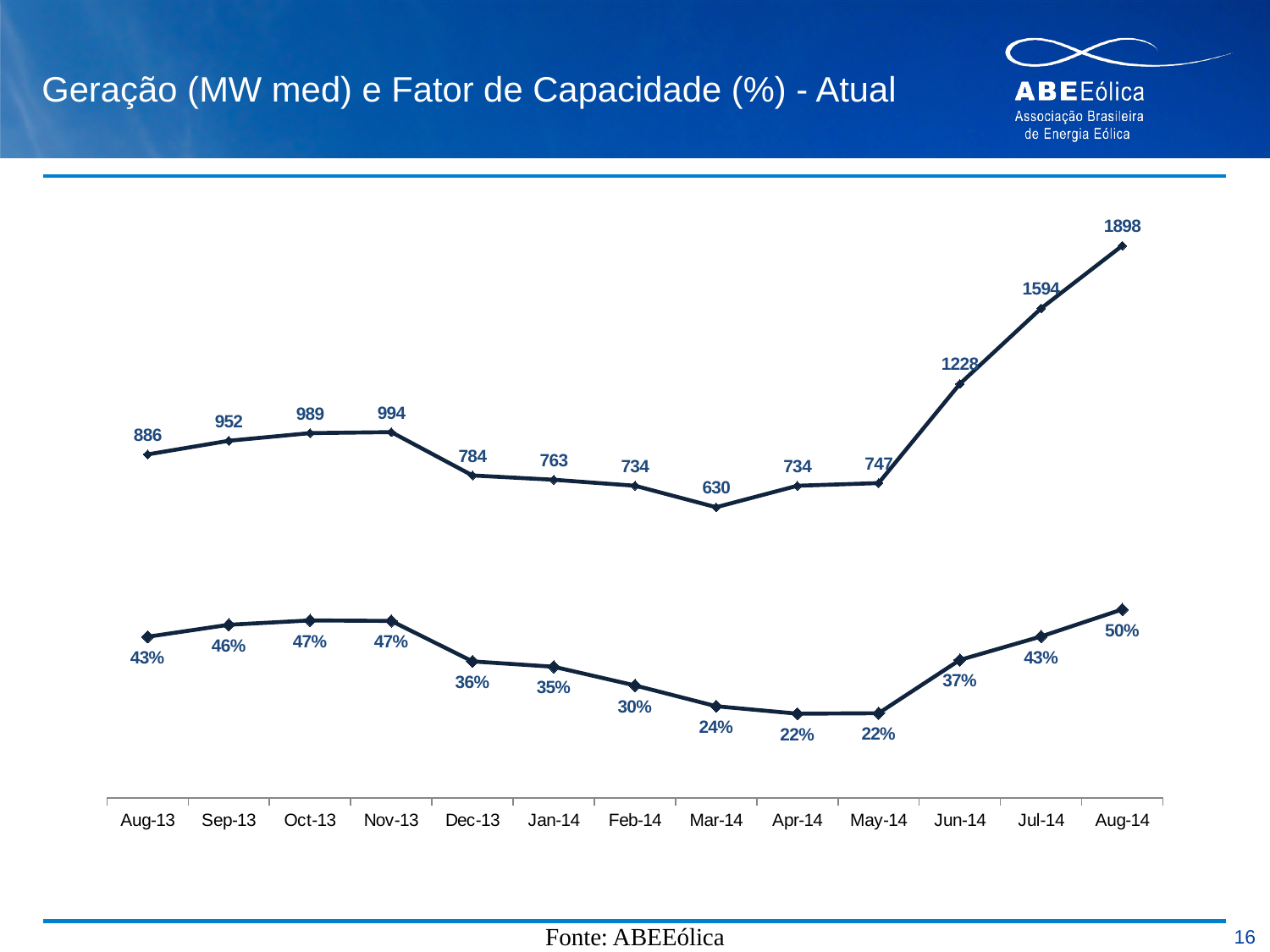
In which month is the capacity factor (%) highest? Aug-14 What type of chart is shown on the slide? line chart What is the title of the slide? Geração (MW med) e Fator de Capacidade (%) - Atual How many months are plotted along the x axis? 13 How does the generation (MW med) line change from May-14 to Aug-14? It rises What is the generation (MW med) value for Aug-14? 1898 What is the capacity factor (%) for Mar-14? 24% Which month has a higher generation (MW med) value, Sep-13 or Jan-14? Sep-13 What is the difference in generation (MW med) between Aug-14 and Jul-14? 304 What is the difference in capacity factor between Nov-13 and Dec-13? 11% What is the generation (MW med) value for Dec-13? 784 In which month is the generation (MW med) lowest? Mar-14